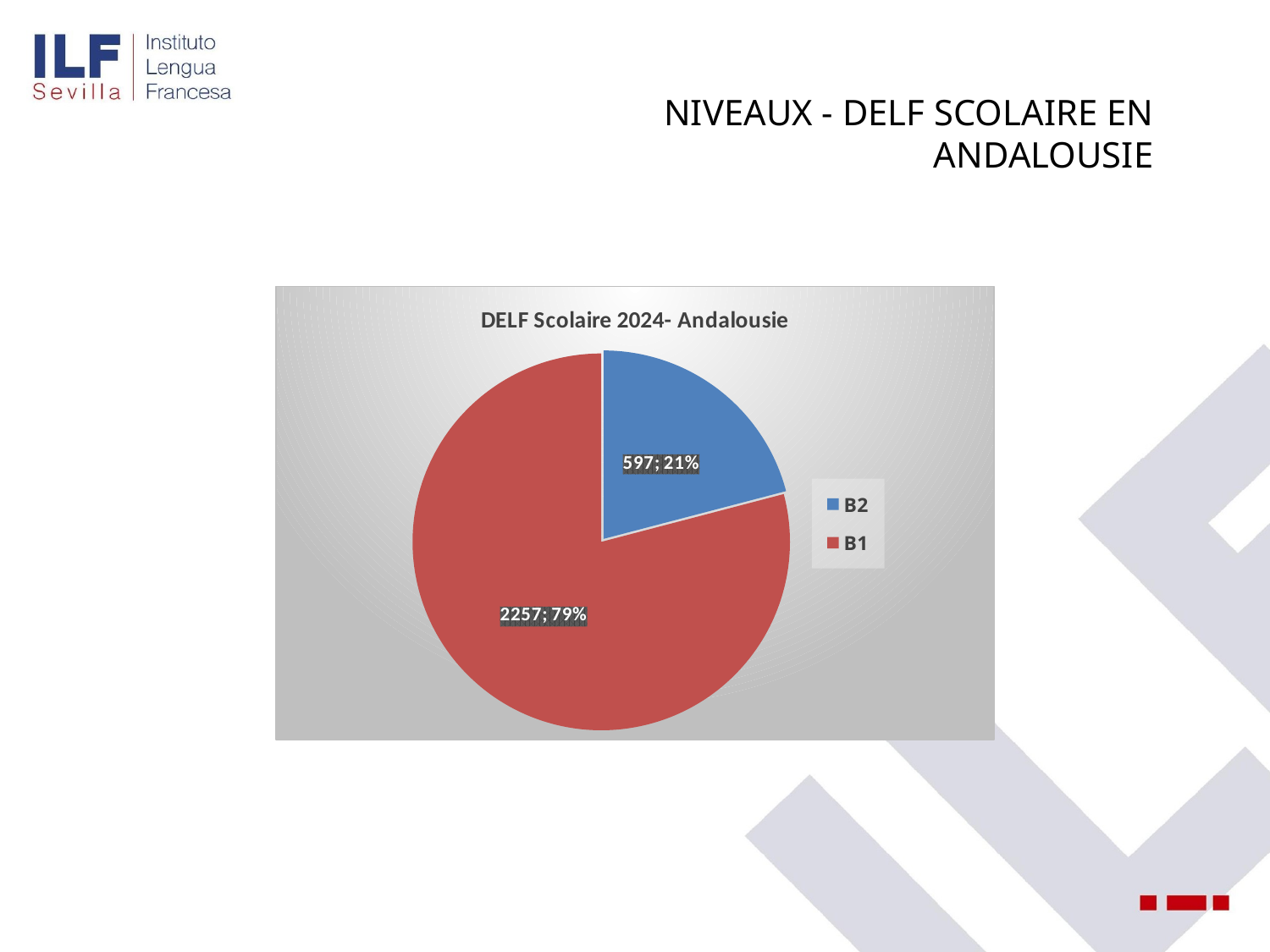
What is the value for B2? 597 Which level has the largest slice? B1 What share of the pie does B2 represent? 21% Which level has the smallest slice? B2 What is the title of the chart? DELF Scolaire 2024- Andalousie What share of the pie does B1 represent? 79% How many slices does the pie chart have? 2 What type of chart is shown on the slide? pie chart What is the total of the two slices? 2854 What is the difference between the values for B1 and B2? 1660 How many entries does the legend list? 2 What is the value for B1? 2257